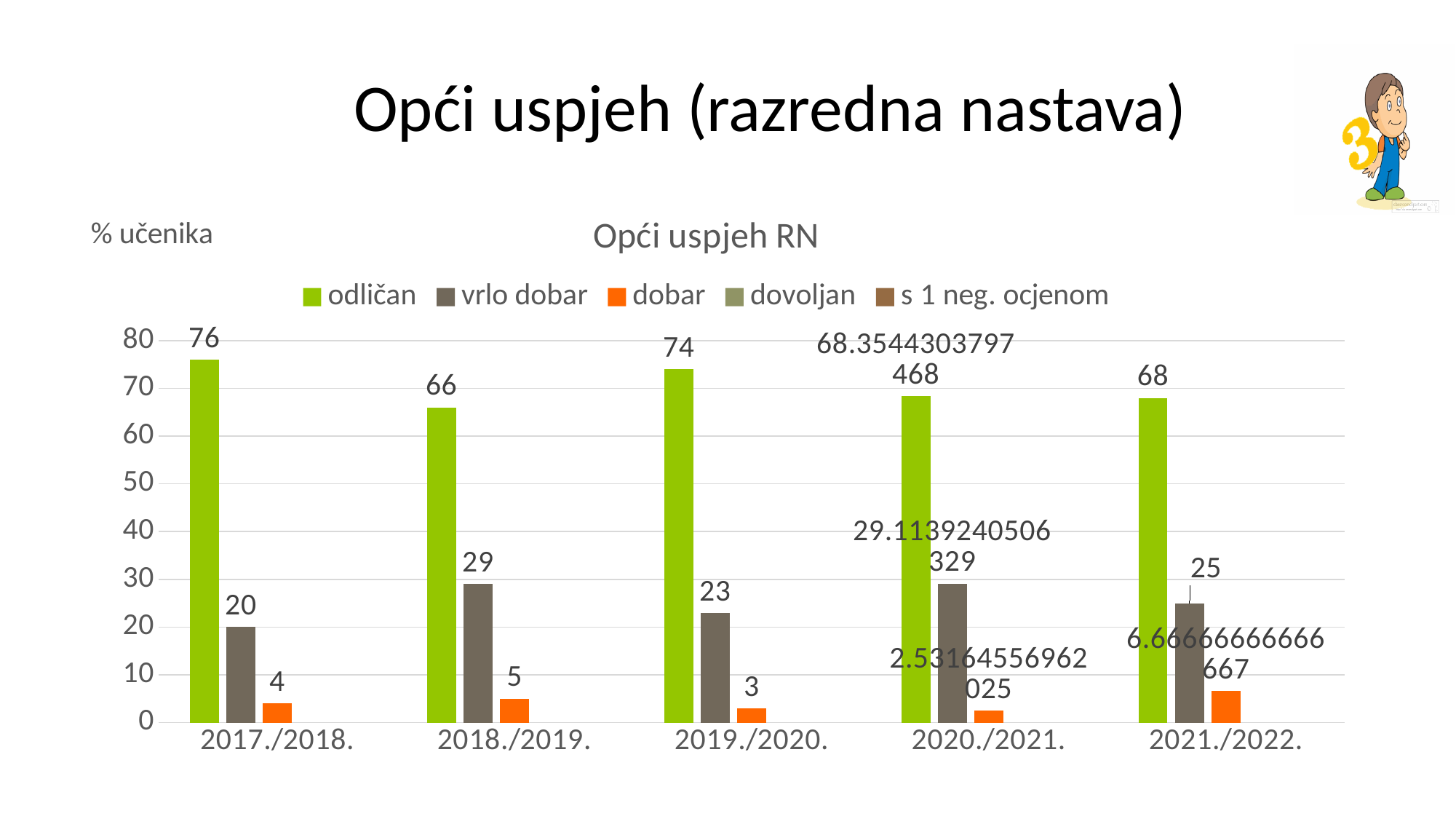
How many series does the legend list? 5 What is the value for odličan in 2021./2022.? 68 Which is larger, the vrlo dobar value in 2019./2020. or in 2021./2022.? 2021./2022. What is the value for dobar in 2019./2020.? 3 What is the difference between the odličan values for 2017./2018. and 2018./2019.? 10 What is the value for odličan in 2017./2018.? 76 What type of chart is shown on the slide? bar chart In which school year is the value for odličan highest? 2017./2018. What is the value for vrlo dobar in 2018./2019.? 29 How many school years are shown on the x axis? 5 What is the title of the chart? Opći uspjeh RN In which school year is the value for vrlo dobar lowest? 2017./2018.